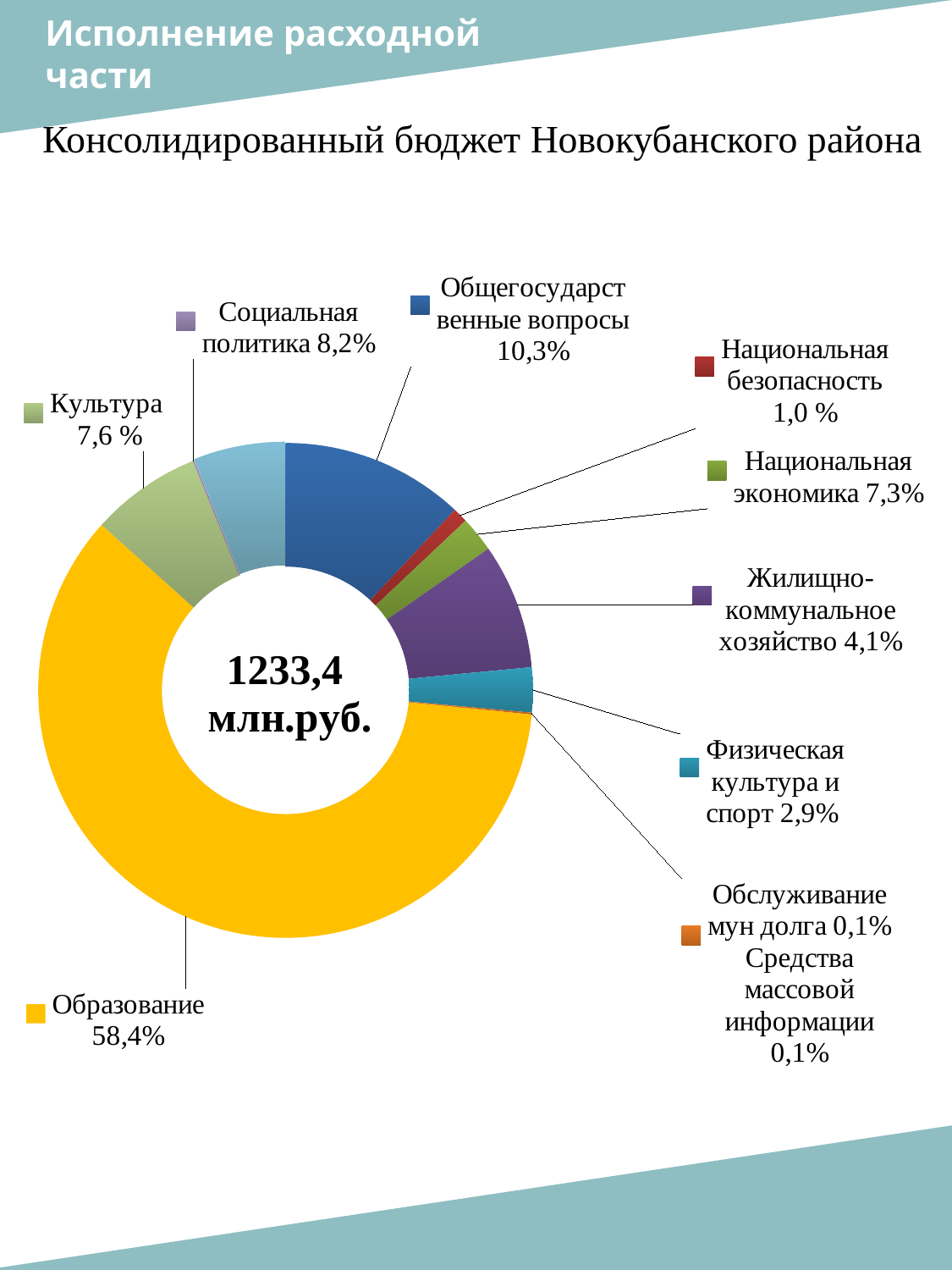
What is the value shown for Национальная безопасность? 1,0 % What is the difference between the shares of Социальная политика and Культура? 0,6% What kind of chart is shown on the slide? Doughnut chart Which is larger, Социальная политика or Культура? Социальная политика What is the value shown for Физическая культура и спорт? 2,9% Which category has the largest share of the chart? Образование What is the difference between the shares of Общегосударственные вопросы and Национальная экономика? 3,0% What total amount is printed in the centre of the chart? 1233,4 млн.руб. What is the value shown for Общегосударственные вопросы? 10,3% What share of the doughnut chart does Образование account for? 58,4% How many categories are shown in the chart? 10 What is the value shown for Жилищно-коммунальное хозяйство? 4,1%